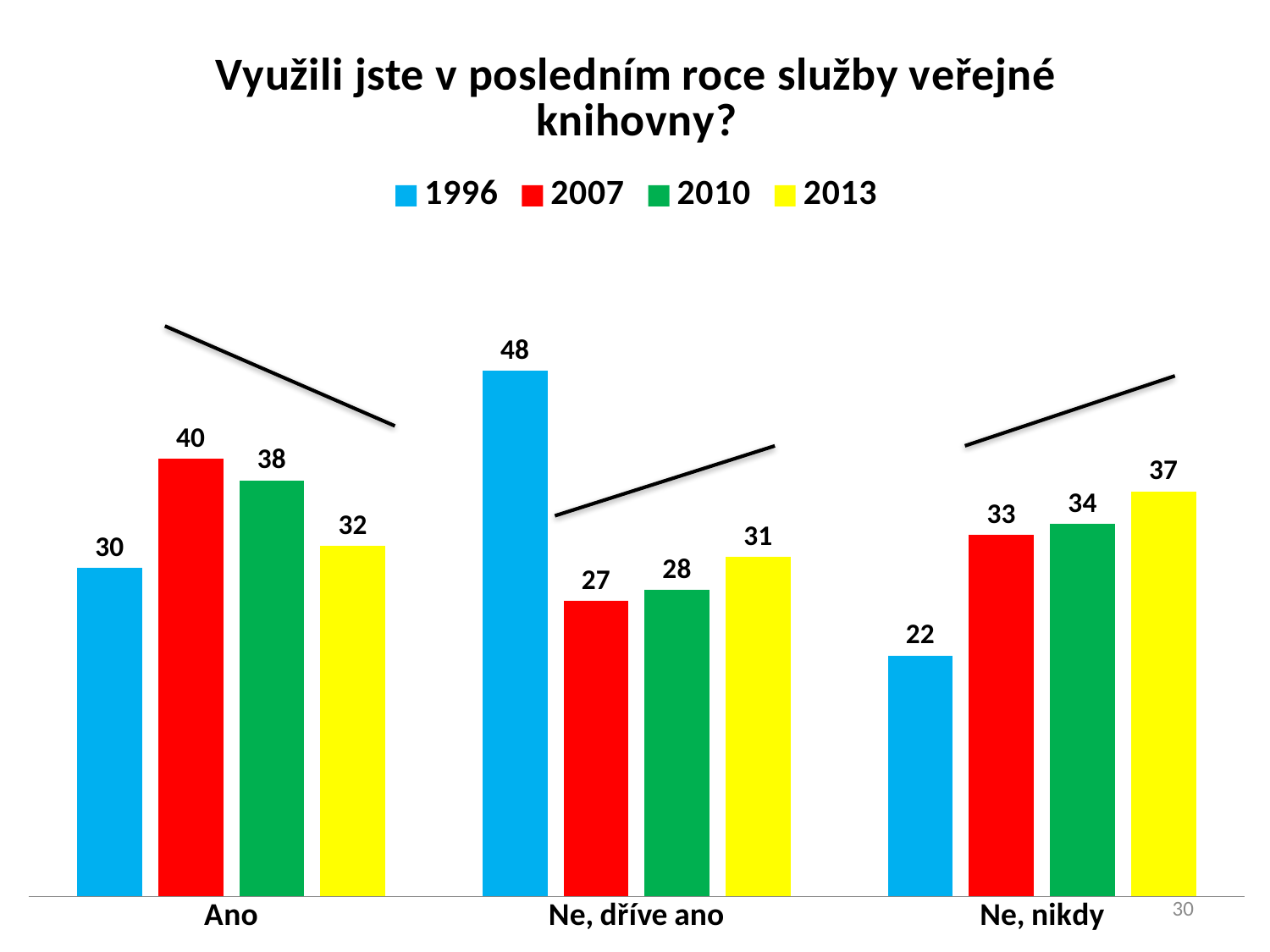
What colour represents the 2010 series in the legend? green Do the values in the "Ne, nikdy" category rise or fall from 1996 to 2013? rise What is the difference between the 1996 and 2013 values in the "Ne, dříve ano" category? 17 What is the value for 2013 in the "Ne, nikdy" category? 37 What is the value for 2007 in the "Ne, dříve ano" category? 27 Which year has the highest value in the "Ne, dříve ano" category? 1996 Which year has the lowest value in the "Ne, nikdy" category? 1996 How many series does the legend list? 4 What is the value for 1996 in the "Ano" category? 30 Which is larger in the "Ano" category: the value for 2007 or the value for 2013? 2007 What kind of chart is shown on the slide? bar chart How many categories are shown on the x axis? 3